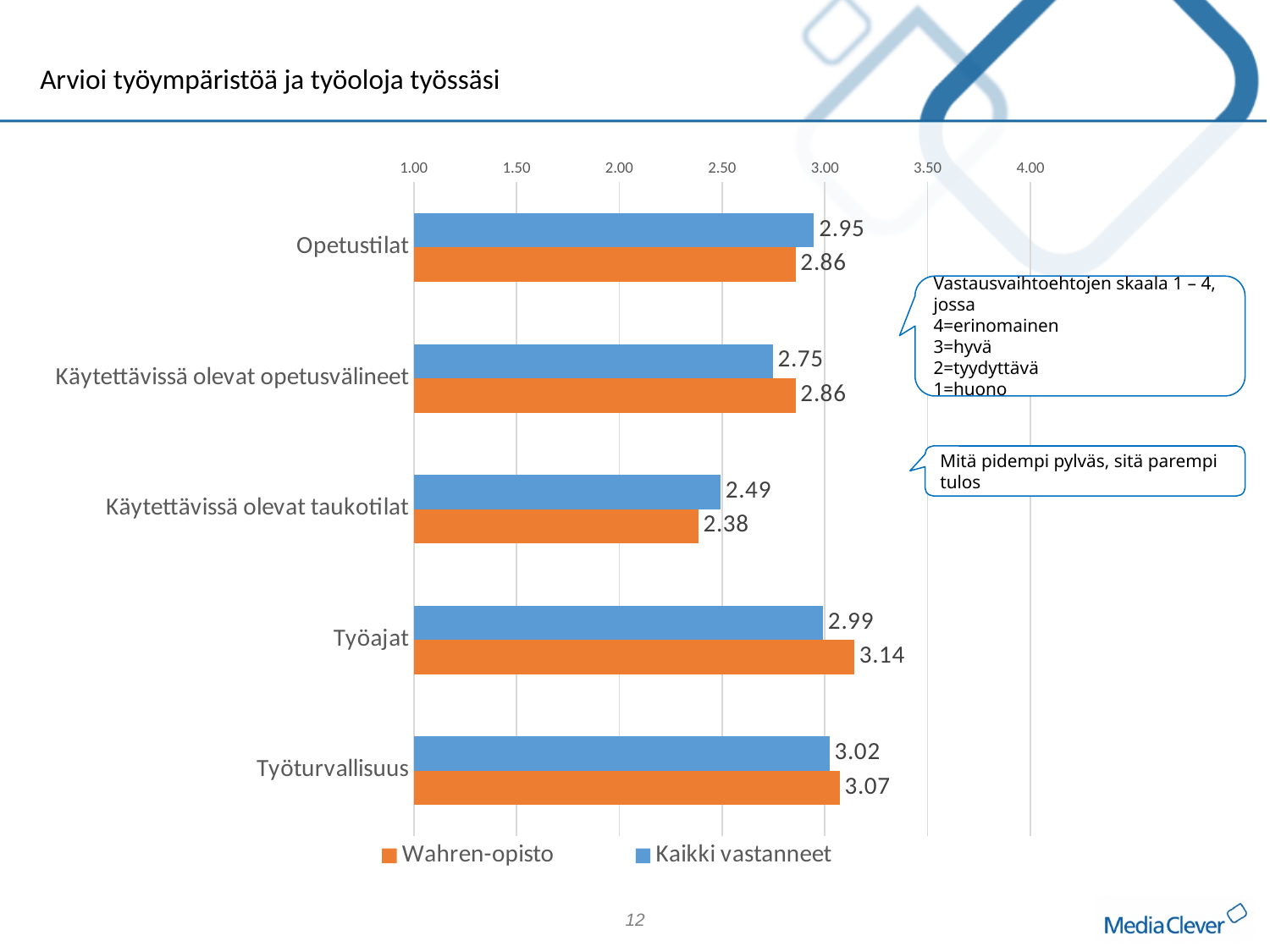
What is the difference between the Wahren-opisto and Kaikki vastanneet values for Työajat? 0.15 Which category has the highest value for Wahren-opisto? Työajat What is the value for Wahren-opisto for Työajat? 3.14 How many categories are shown on the chart? 5 Which category has the lowest value for Kaikki vastanneet? Käytettävissä olevat taukotilat What is the value for Wahren-opisto for Käytettävissä olevat taukotilat? 2.38 How many series does the legend list? 2 Which colour represents Wahren-opisto in the chart? Orange What is the value for Kaikki vastanneet for Opetustilat? 2.95 What is the value for Kaikki vastanneet for Käytettävissä olevat opetusvälineet? 2.75 What kind of chart is shown on the slide? Bar chart For Käytettävissä olevat opetusvälineet, which series has the larger value, Wahren-opisto or Kaikki vastanneet? Wahren-opisto